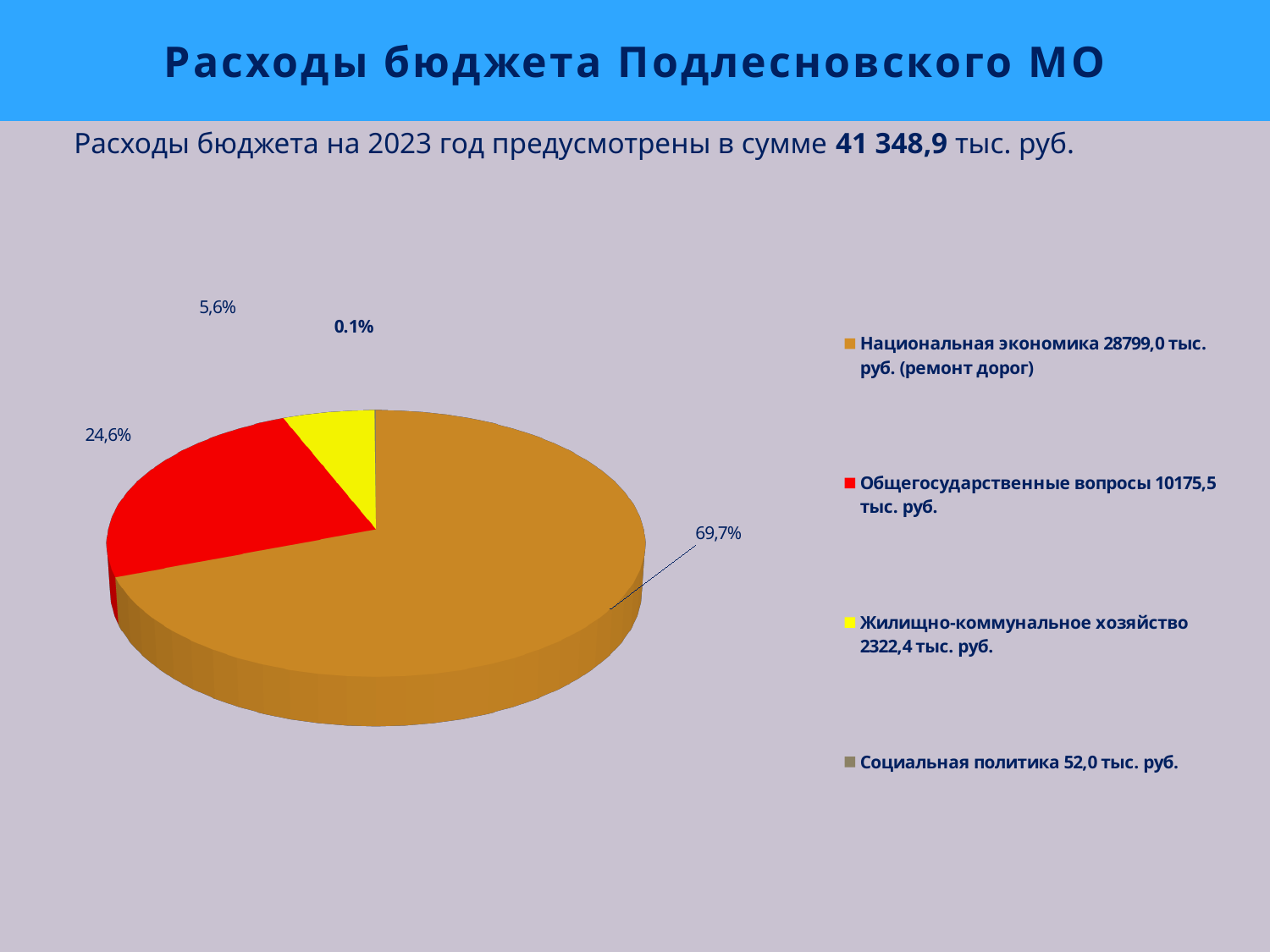
How many slices does the pie chart have? 4 What share of the pie does Общегосударственные вопросы take? 24,6% What share of the pie does Социальная политика take? 0.1% What kind of chart is shown on the slide? Pie chart What amount in тыс. руб. does the legend give for Жилищно-коммунальное хозяйство? 2322,4 тыс. руб. What colour is the slice for Общегосударственные вопросы? Red By how many percentage points does the share of Национальная экономика exceed the share of Общегосударственные вопросы? 45,1 What share of the pie does Жилищно-коммунальное хозяйство take? 5,6% Which category has the largest slice of the pie? Национальная экономика (ремонт дорог) Which category has the smallest slice of the pie? Социальная политика What amount in тыс. руб. does the legend give for Общегосударственные вопросы? 10175,5 тыс. руб.